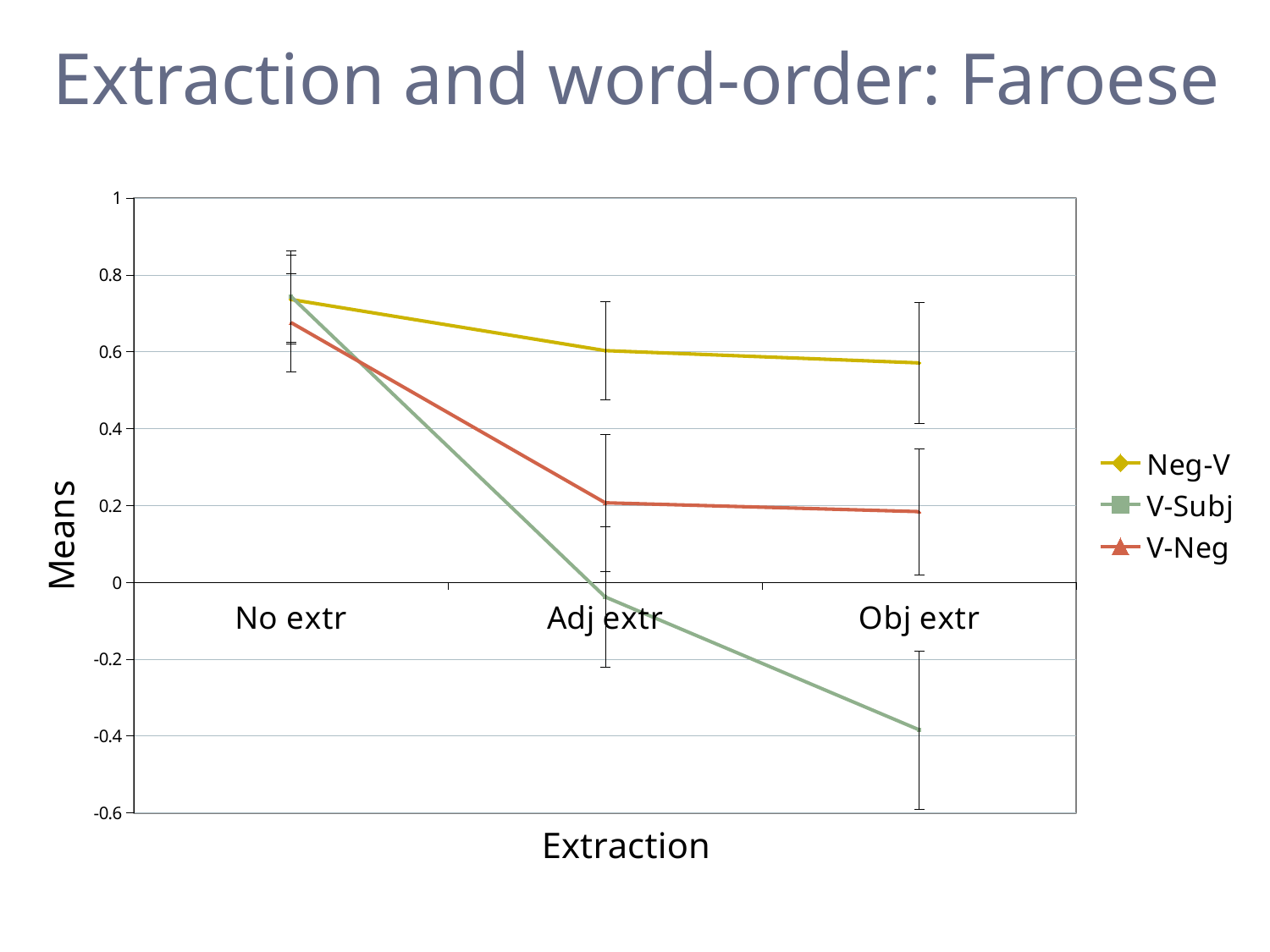
How many series does the legend list? 3 Which series has the lowest value at Obj extr? V-Subj What kind of chart is shown on the slide? line chart Is the value for Neg-V at Obj extr greater or less than 0.4? greater Is the value for V-Subj at Obj extr greater or less than 0? less Do the values for V-Subj rise or fall from No extr to Obj extr? fall Which is larger at Adj extr, the value for V-Neg or the value for V-Subj? V-Neg What is the label of the y axis? Means Which series has the highest value at Adj extr? Neg-V How many categories are shown on the x axis? 3 Is the value for V-Neg at Adj extr greater or less than 0.4? less What is the title of the chart on the slide? Extraction and word-order: Faroese